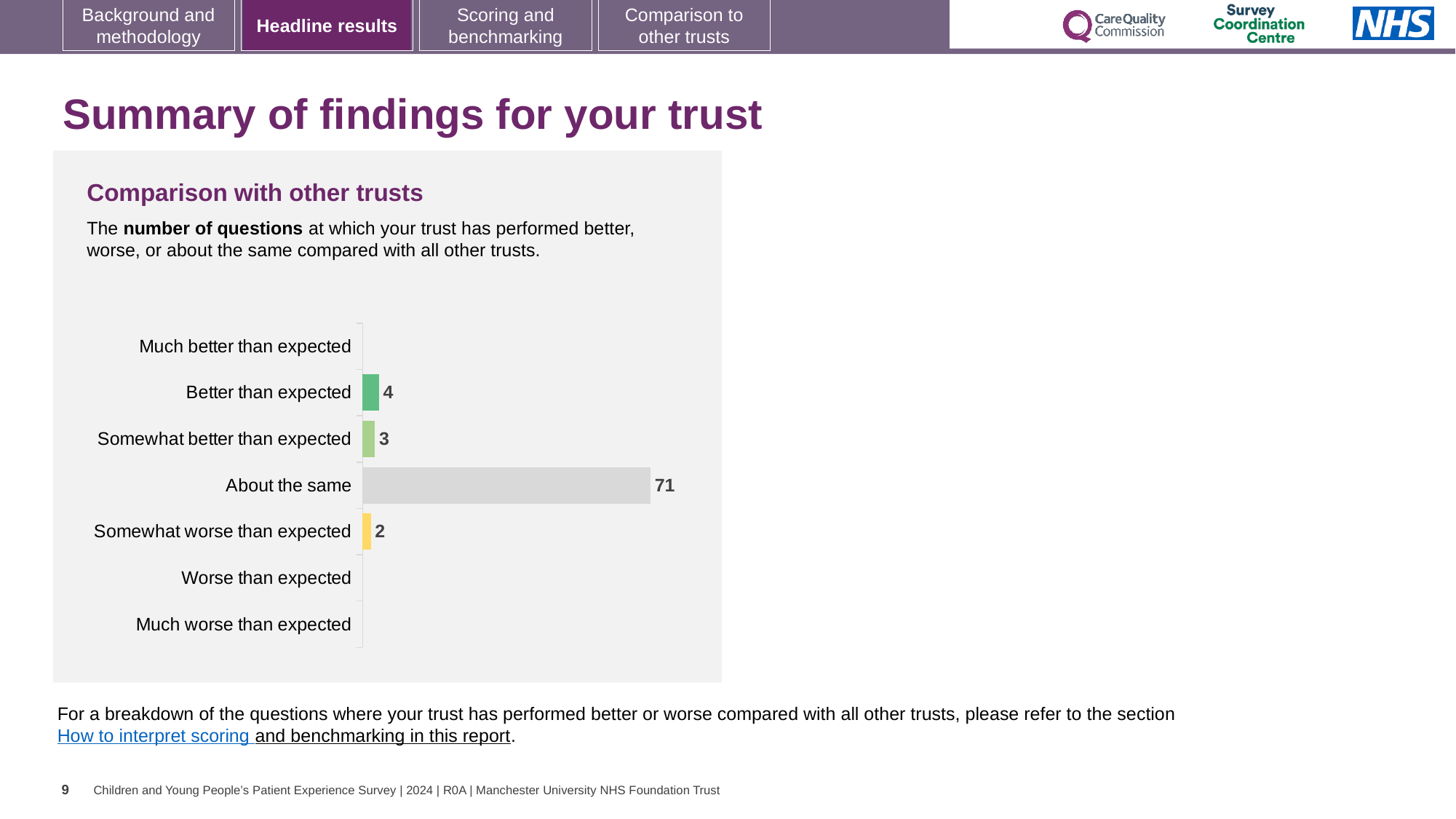
What is the difference between 'Better than expected' and 'Somewhat worse than expected'? 2 What is the value for 'Somewhat worse than expected'? 2 What is the value for 'Somewhat better than expected'? 3 What is the value for 'Better than expected'? 4 Which category has the highest number of questions? About the same How many questions are in the 'About the same' category? 71 What is the title of the chart section? Comparison with other trusts What kind of chart is shown on the slide? Bar chart What is the difference between the 'About the same' value and the 'Better than expected' value? 67 How many categories are listed on the chart's axis? 7 Which is larger, 'Better than expected' or 'Somewhat better than expected'? Better than expected What colour is the 'Somewhat worse than expected' bar? Yellow